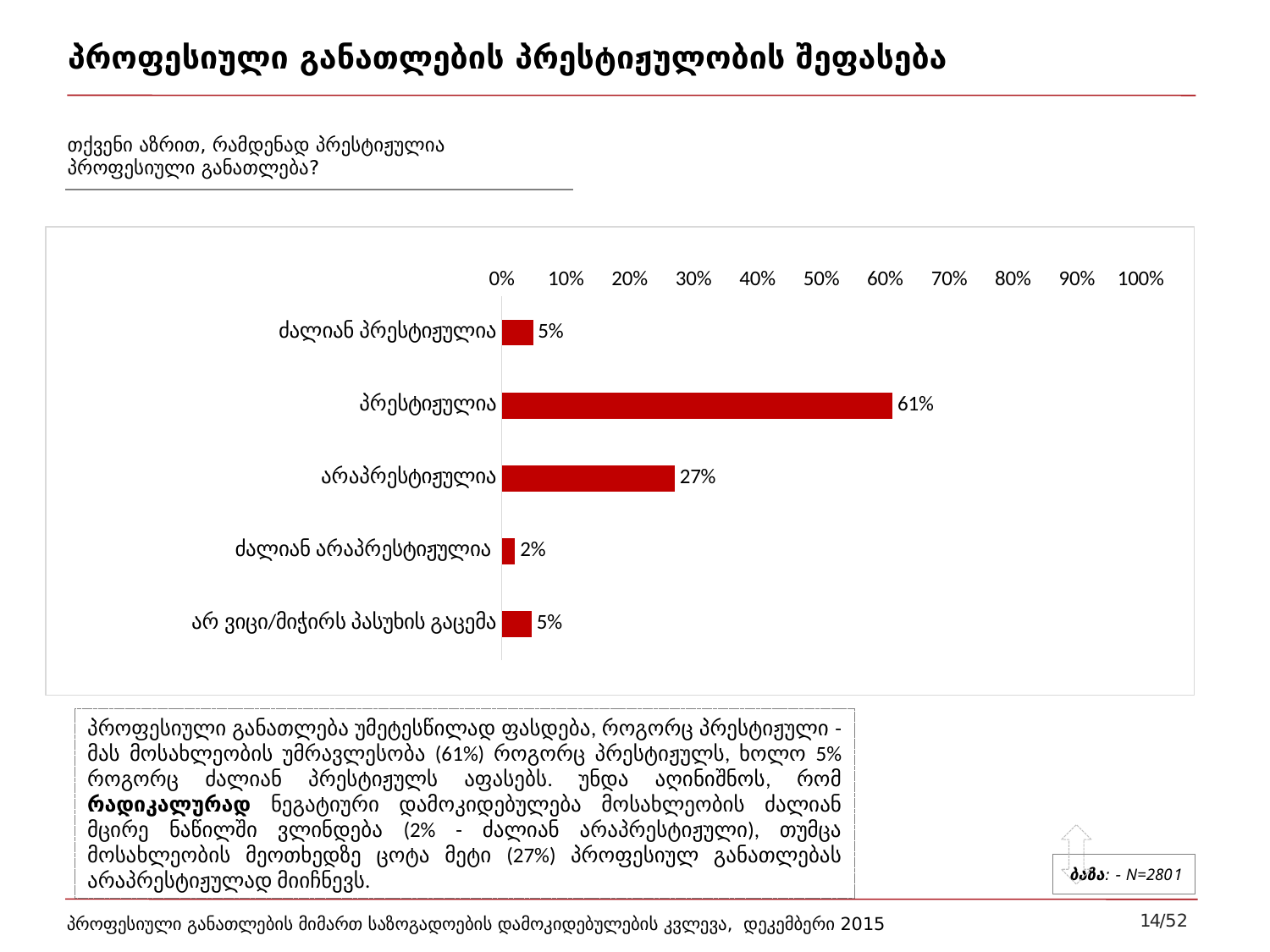
Which category has the lowest value? ძალიან არაპრესტიჟულია What is the value for ძალიან არაპრესტიჟულია? 2% What is the sample size (N) shown on the slide? N=2801 Which category has the highest value? პრესტიჟულია Is the value for პრესტიჟულია greater or less than 50%? greater What is the value for არაპრესტიჟულია? 27% Which is larger, the value for არაპრესტიჟულია or the value for ძალიან პრესტიჟულია? არაპრესტიჟულია What is the value for ძალიან პრესტიჟულია? 5% What is the value for პრესტიჟულია? 61% What is the difference between the values for პრესტიჟულია and არაპრესტიჟულია? 34% What kind of chart is shown on the slide? bar chart How many categories are shown in the chart? 5